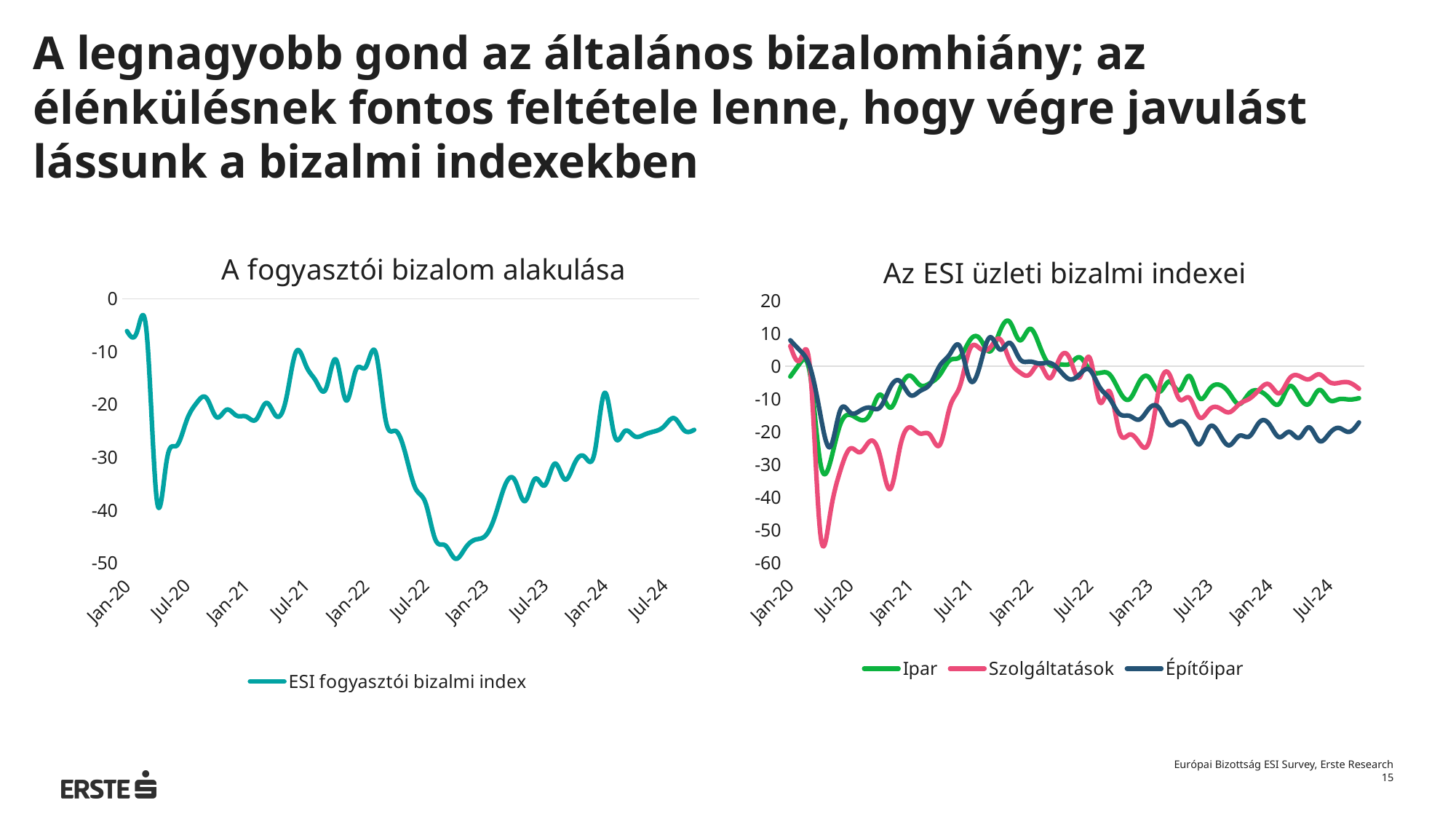
What is the name of the series plotted in the chart "A fogyasztói bizalom alakulása"? ESI fogyasztói bizalmi index What kind of chart is "A fogyasztói bizalom alakulása"? line chart In "Az ESI üzleti bizalmi indexei", is the value of Ipar at Jan-22 greater or less than 0? greater In "A fogyasztói bizalom alakulása", is the value at Jan-23 greater or less than -40? less How many series does the legend of "Az ESI üzleti bizalmi indexei" list? 3 In "A fogyasztói bizalom alakulása", is the value at Jan-20 greater or less than -10? greater In "A fogyasztói bizalom alakulása", does the index rise or fall between Jul-22 and Jan-23? fall In "Az ESI üzleti bizalmi indexei", at Jul-24 which is higher, Szolgáltatások or Építőipar? Szolgáltatások In "Az ESI üzleti bizalmi indexei", which series reached the lowest value in 2020? Szolgáltatások What are the legend entries of the chart "Az ESI üzleti bizalmi indexei"? Ipar, Szolgáltatások, Építőipar